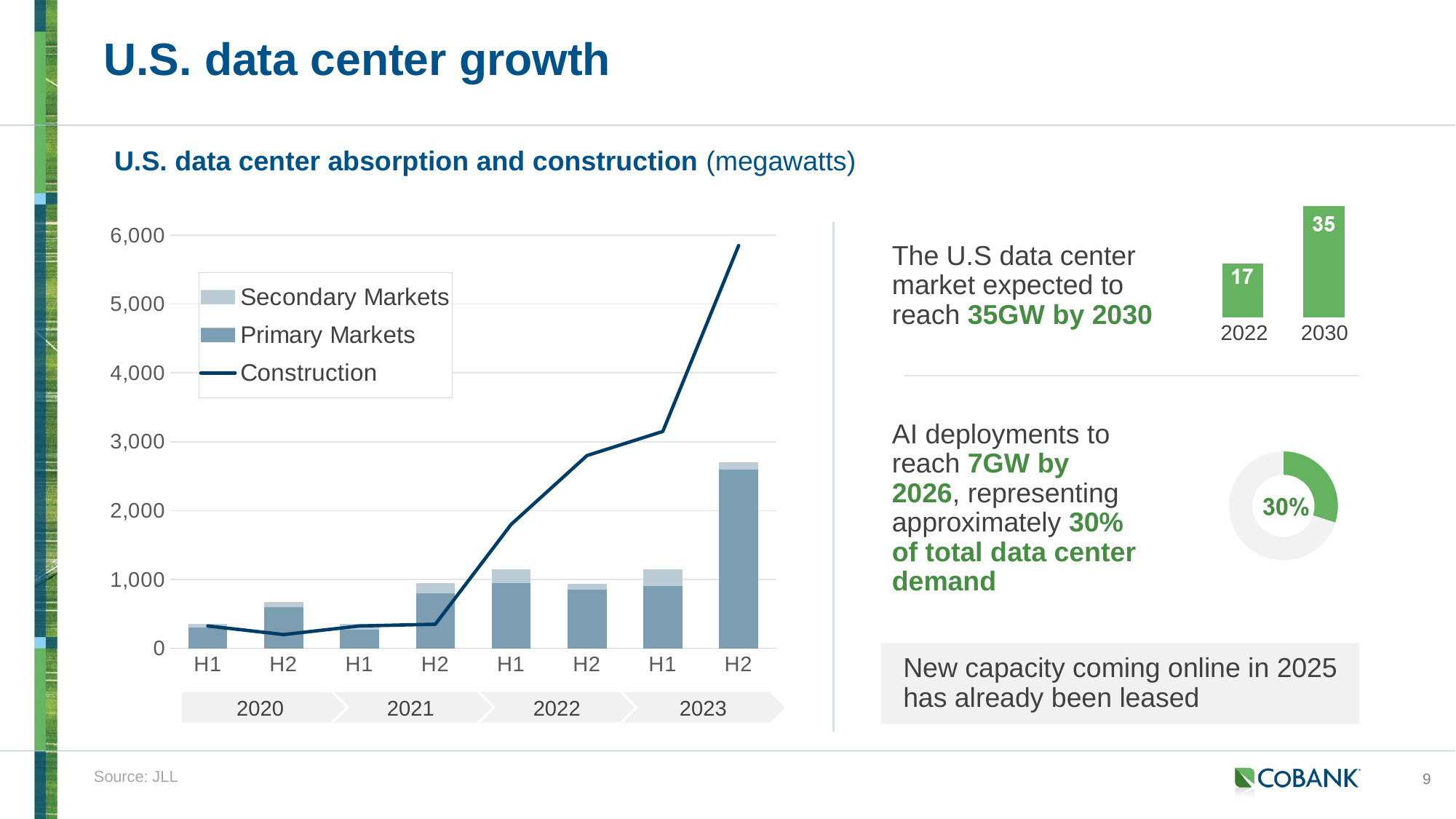
What percentage is shown in the donut chart on the right of the slide? 30% In the 'U.S. data center absorption and construction' chart, which period has the tallest stacked bar? H2 2023 In the 'U.S. data center absorption and construction' chart, which series is drawn as a line rather than bars? Construction In the small bar chart on the right showing 2022 and 2030, what is the difference between the 2030 and 2022 values? 18 In the 'U.S. data center absorption and construction' chart, how many series does the legend list? 3 In the 'U.S. data center absorption and construction' chart, is the Construction value for H1 2022 greater or less than 1,000? greater In the 'U.S. data center absorption and construction' chart, is the Construction value for H2 2023 greater or less than 5,000? greater In the 'U.S. data center absorption and construction' chart, does the Construction line generally rise or fall from H1 2021 to H2 2023? rise In the 'U.S. data center absorption and construction' chart, how many half-year periods are plotted on the x axis? 8 In the 'U.S. data center absorption and construction' chart, is the total stacked bar for H2 2023 greater or less than 2,000? greater In the small bar chart on the right showing 2022 and 2030, what is the value for 2030? 35